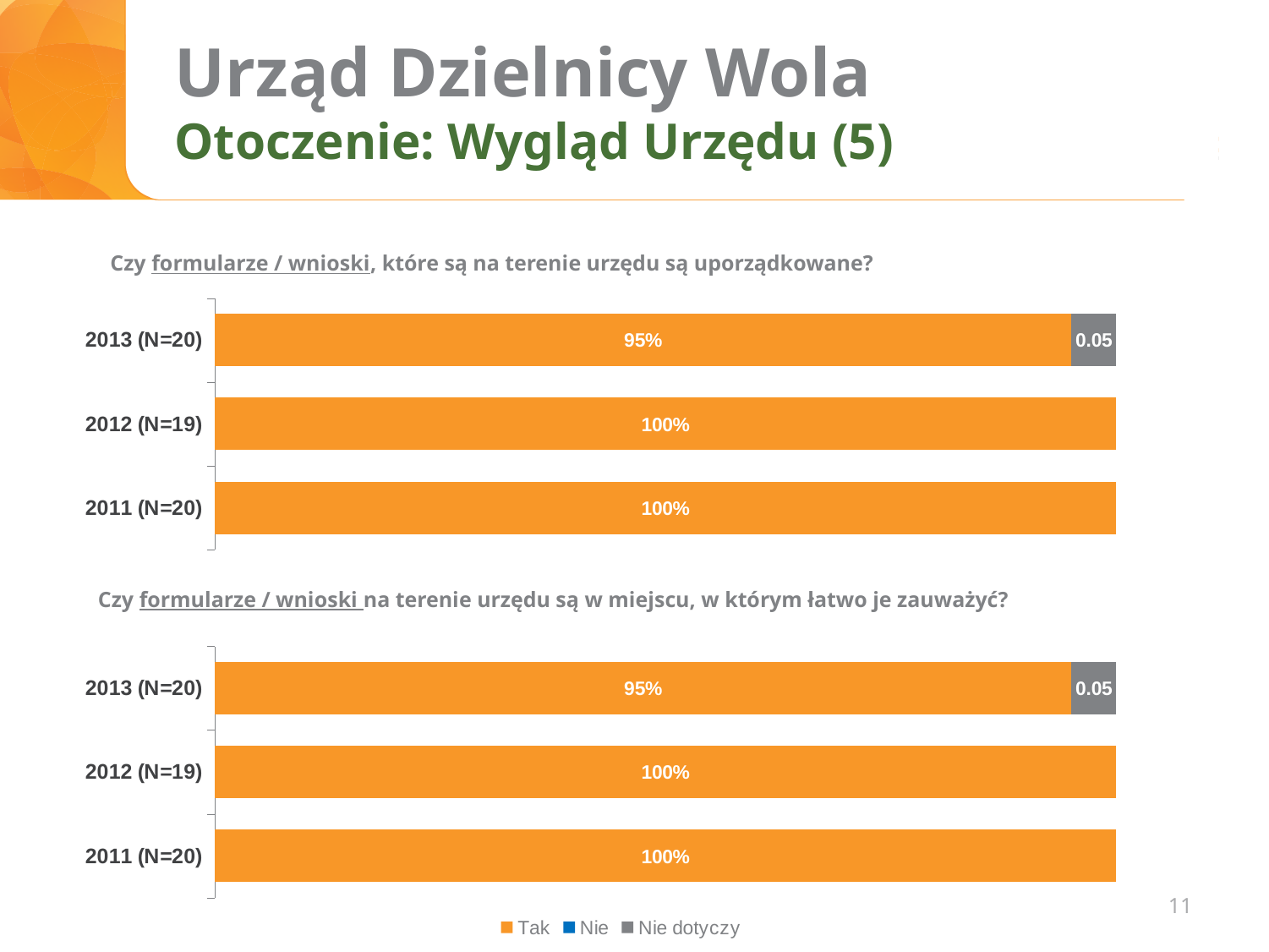
Which legend entry is shown in orange? Tak How many series does the legend at the bottom of the slide list? 3 In the top chart, which year has the lowest "Tak" value? 2013 (N=20) In the bottom chart ("Czy formularze / wnioski na terenie urzędu są w miejscu, w którym łatwo je zauważyć?"), what is the "Tak" value for 2011 (N=20)? 100% In the top chart, what label is printed on the grey segment for 2013 (N=20)? 0.05 How many year categories does the bottom chart show? 3 In the top chart, what is the difference between the "Tak" value for 2011 (N=20) and for 2013 (N=20)? 5% In the bottom chart, is the "Tak" value for 2012 (N=19) larger or smaller than for 2013 (N=20)? larger In the top chart ("Czy formularze / wnioski, które są na terenie urzędu są uporządkowane?"), what is the "Tak" value for 2013 (N=20)? 95% In the bottom chart, what is the "Tak" value for 2013 (N=20)? 95% What type of chart is the top chart? bar chart In the top chart, what is the "Tak" value for 2012 (N=19)? 100%